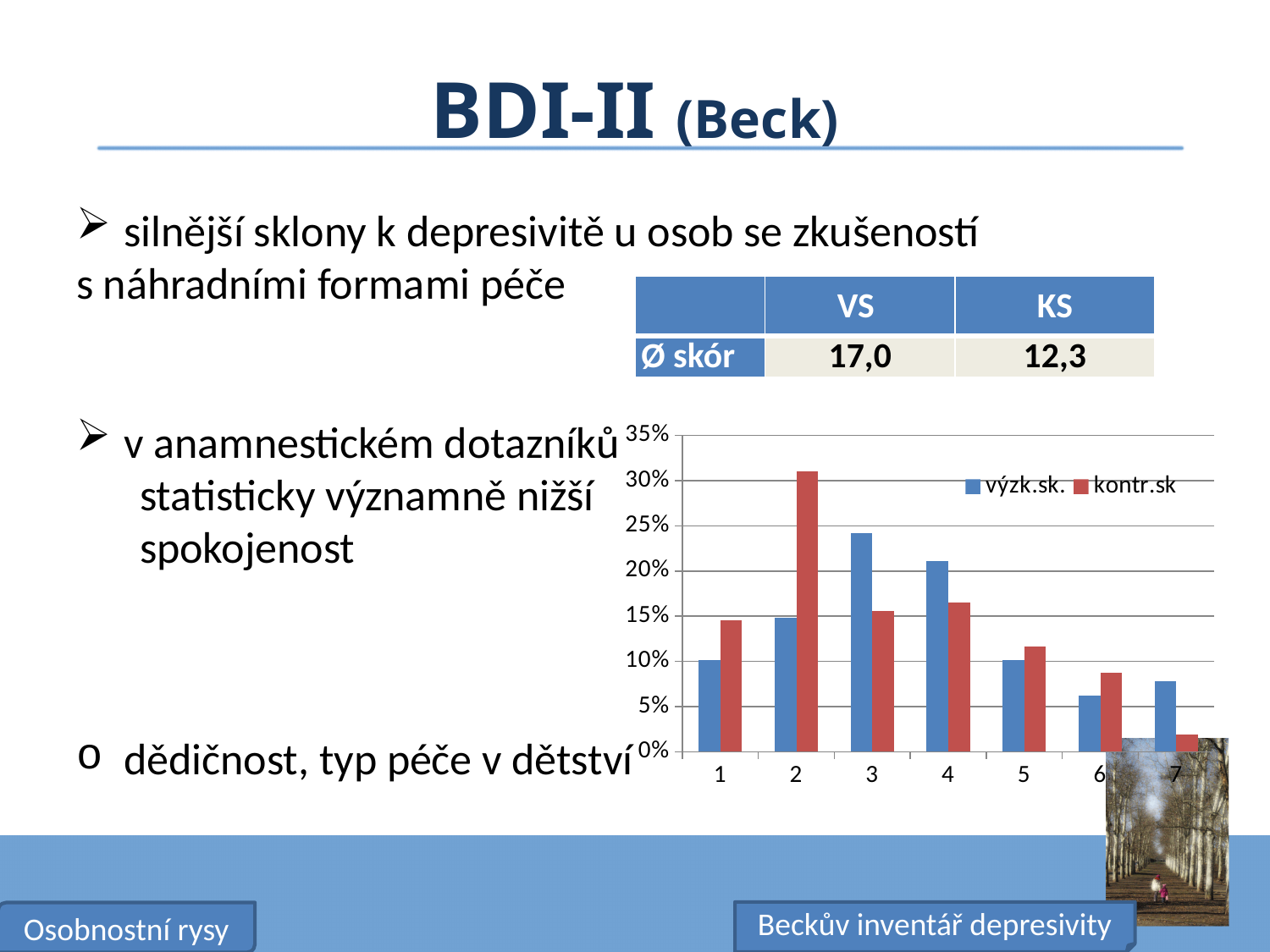
For which category is the kontr.sk value lowest? 7 For which category is the výzk.sk. value highest? 3 What are the two series named in the chart legend? výzk.sk. and kontr.sk Is the kontr.sk value for category 2 greater or less than 25%? greater For which category is the kontr.sk value highest? 2 How many categories are shown on the x axis of the chart? 7 In category 4, which series has the larger value, výzk.sk. or kontr.sk? výzk.sk. Is the kontr.sk value for category 7 greater or less than 5%? less What kind of chart is shown on the slide? bar chart In category 3, which series has the larger value, výzk.sk. or kontr.sk? výzk.sk. In category 2, which series has the larger value, výzk.sk. or kontr.sk? kontr.sk How many series does the chart legend list? 2